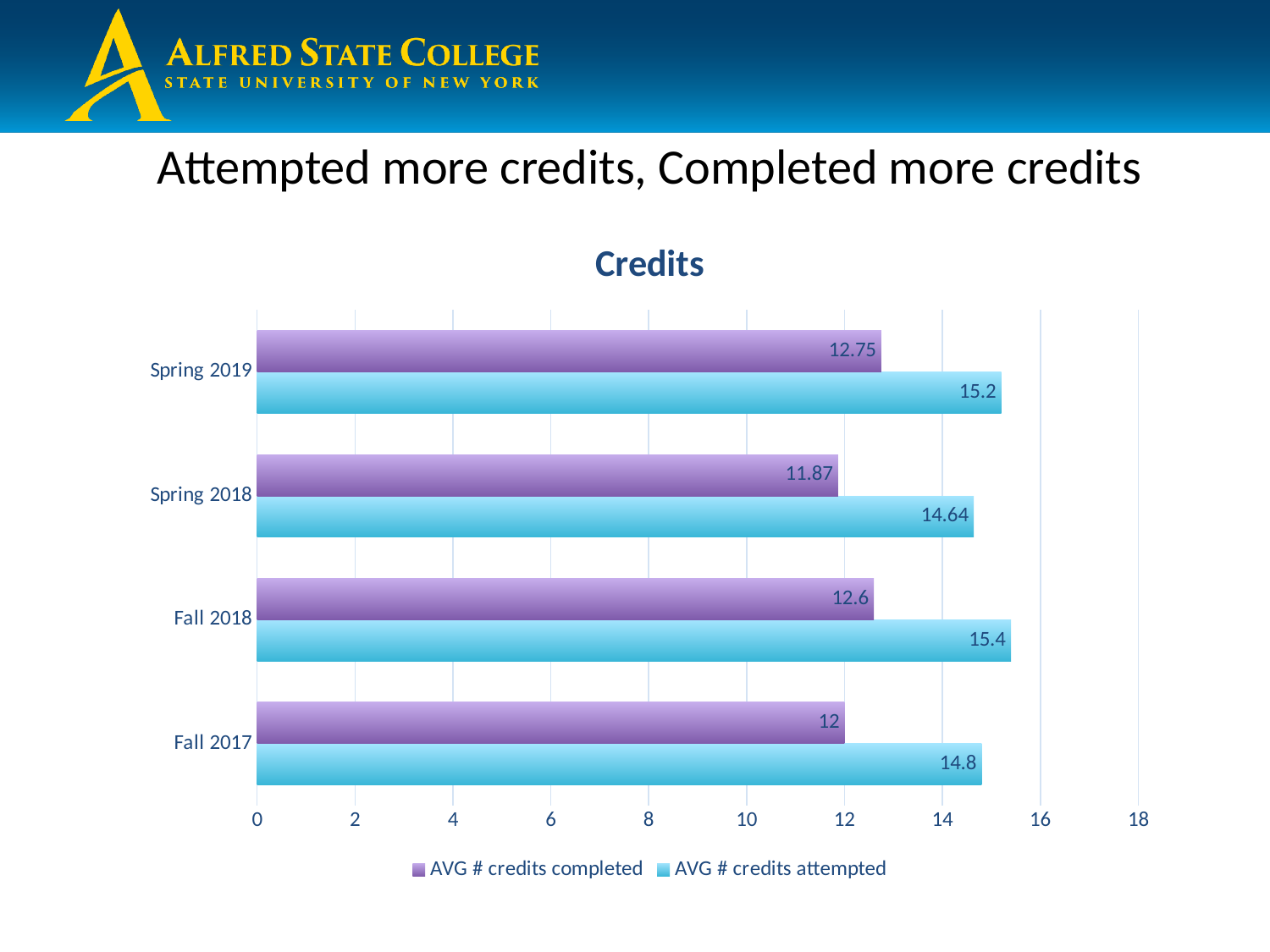
Which term has the highest AVG # credits attempted? Fall 2018 How many terms are shown on the chart? 4 What is the AVG # credits completed for Spring 2018? 11.87 What is the AVG # credits completed for Fall 2017? 12 Is the AVG # credits attempted for Spring 2018 greater or less than 14? greater What kind of chart is shown on the slide? Bar chart How many series does the legend list? 2 Which term has the lowest AVG # credits completed? Spring 2018 Which is larger: AVG # credits completed for Spring 2019 or for Fall 2018? Spring 2019 What is the title of the chart? Credits What is the difference between AVG # credits attempted and AVG # credits completed for Fall 2018? 2.8 What is the AVG # credits attempted for Spring 2019? 15.2